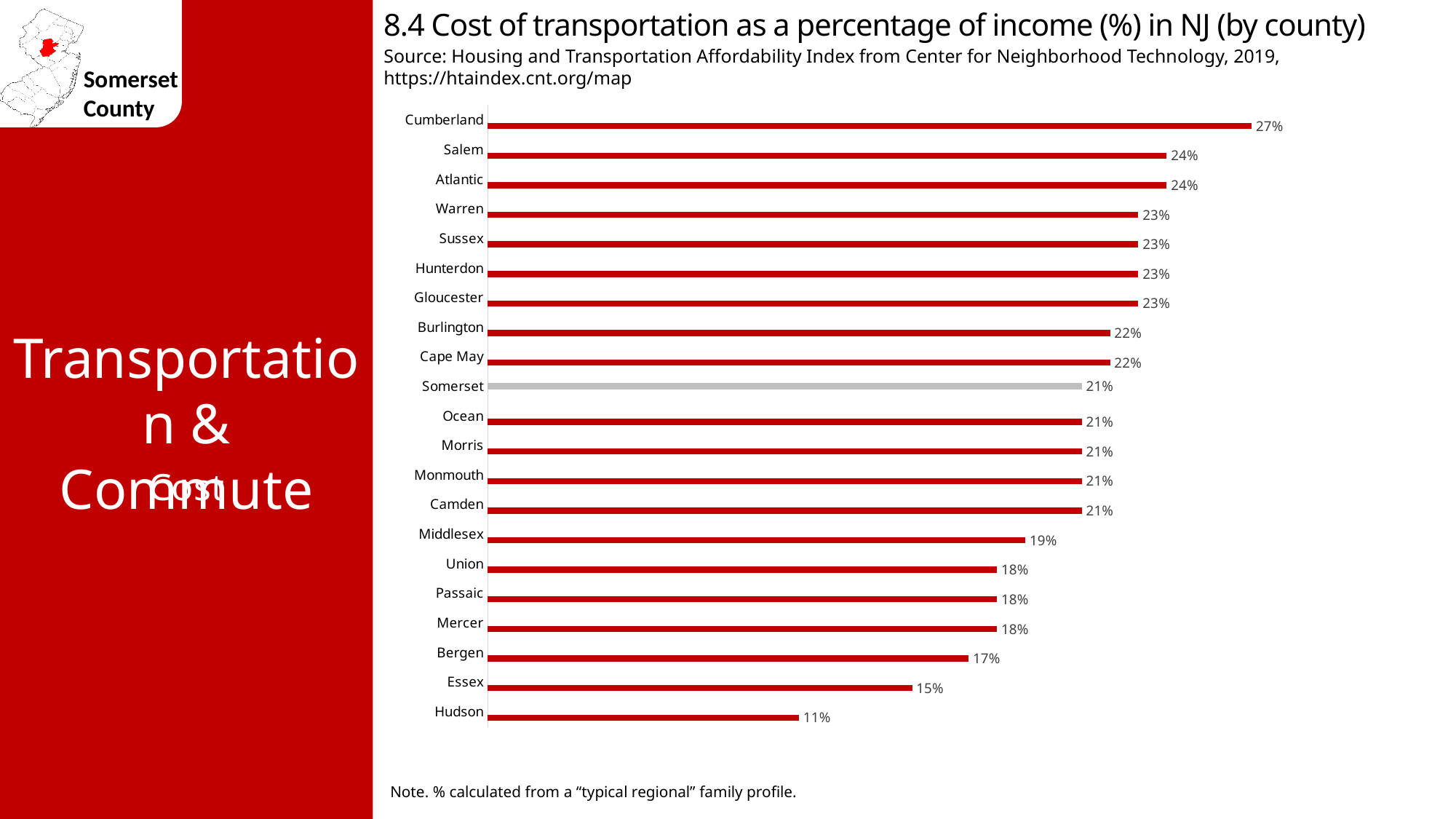
What is the difference between the values for Cumberland and Hudson? 16% What is the cost of transportation as a percentage of income for Somerset County? 21% What is the value shown for Hudson County? 11% Which has a higher value, Bergen or Salem? Salem Which county's bar is shown in a different colour (grey) from the others? Somerset What is the value shown for Middlesex County? 19% What type of chart is shown on the slide? Bar chart How many counties are shown in the chart? 21 What is the value shown for Cumberland County? 27% What is the difference between the values for Somerset and Essex? 6% Which county has the highest cost of transportation as a percentage of income? Cumberland Which county has the lowest cost of transportation as a percentage of income? Hudson